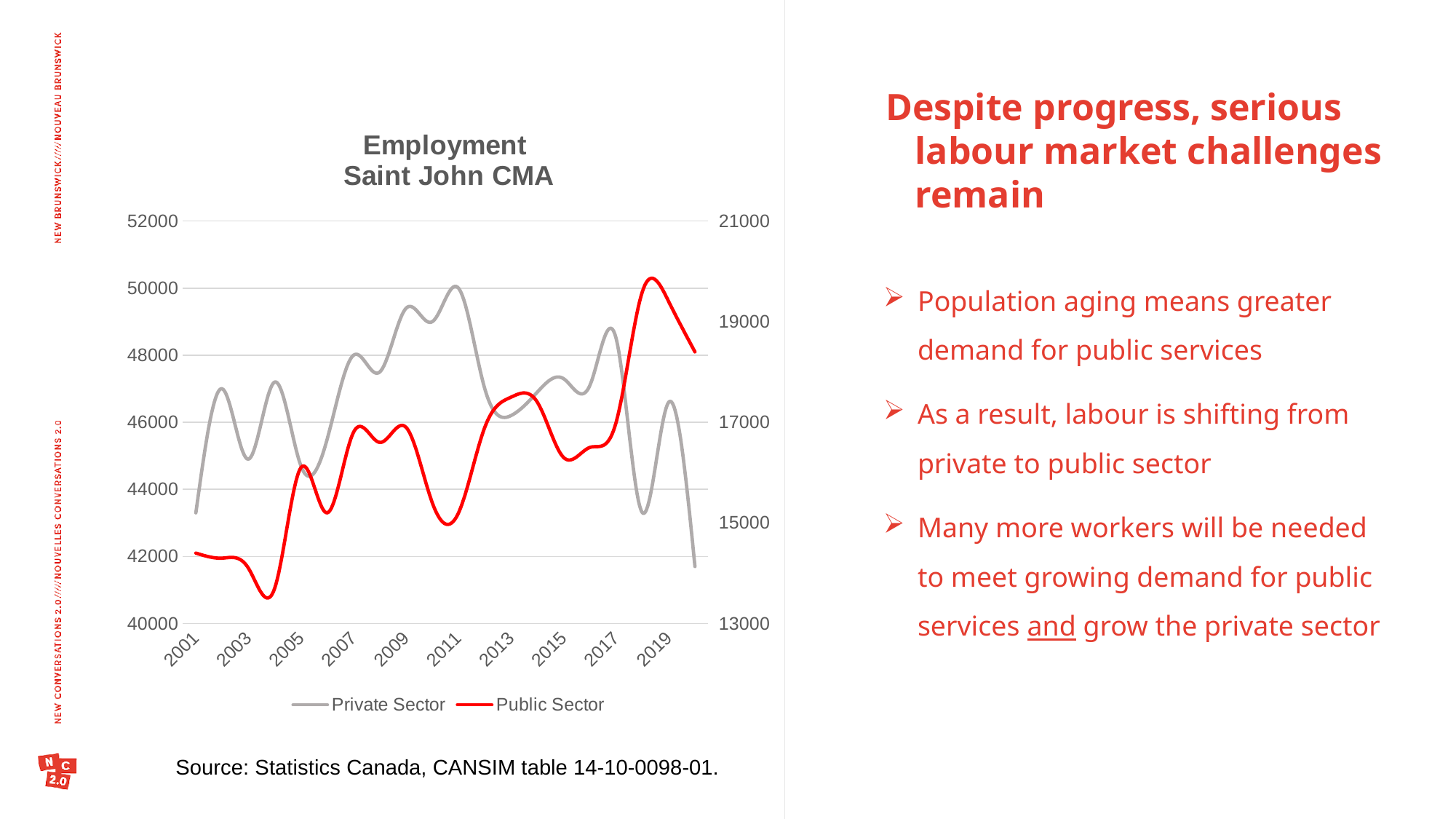
Is the Public Sector value in 2001 greater or less than 15000? less Is the Public Sector value at its 2018 peak greater or less than 19000? greater Which series is drawn in red? Public Sector What kind of chart is shown on the slide? line chart Around which year does the Public Sector line reach its lowest point? 2004 Around which year does the Public Sector line reach its highest point? 2018 Does the Public Sector line overall rise or fall from 2001 to 2018? rise Is the Private Sector value in 2009 greater or less than 48000? greater What is the title of the chart? Employment Saint John CMA How many series does the legend list? 2 Around which year does the Private Sector line reach its highest point? 2011